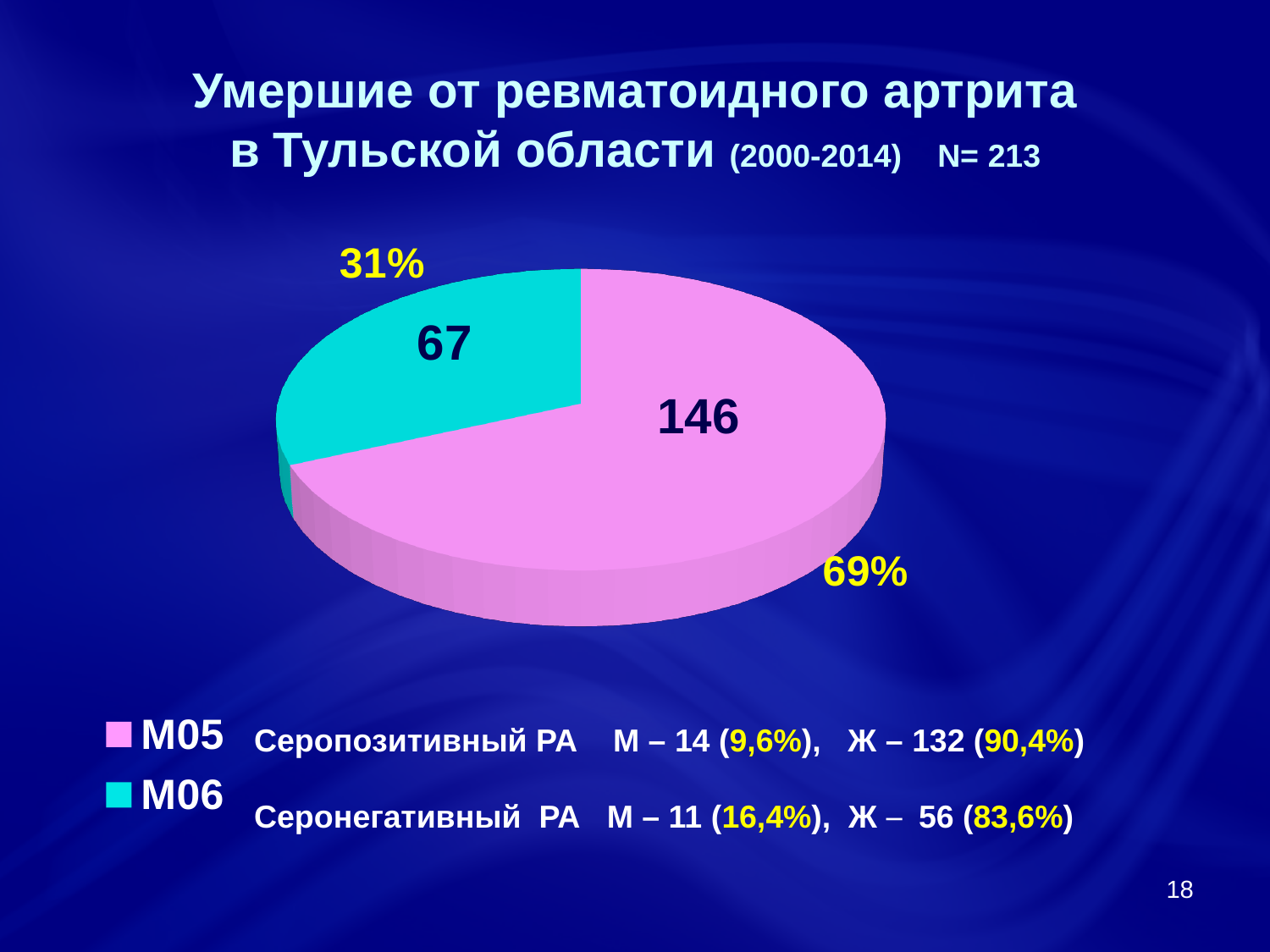
What is the difference between the values for M05 and M06? 79 What colour is the M06 slice in the pie chart? turquoise What share of the pie does M06 represent? 31% What is the value for M05 in the pie chart? 146 What is the value for M06 in the pie chart? 67 Which category has the smallest slice of the pie? M06 What share of the pie does M05 represent? 69% Which category has the largest slice of the pie? M05 What kind of chart is shown on the slide? pie chart Which is larger, the value for M05 or the value for M06? M05 How many entries does the legend list? 2 How many slices does the pie chart have? 2